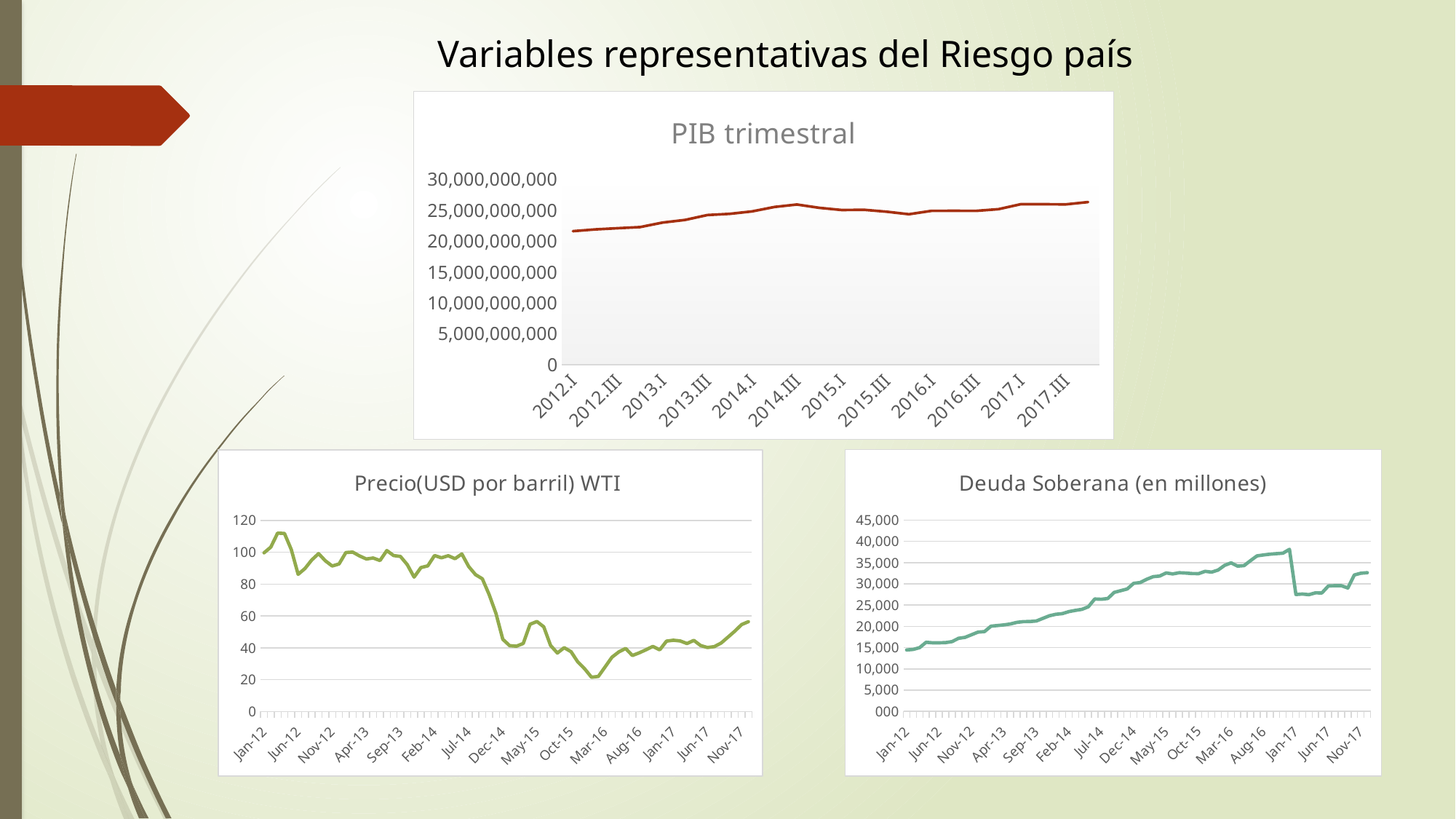
In the 'PIB trimestral' chart, is the value for 2017.III greater or less than 25,000,000,000? greater What kind of chart is the 'PIB trimestral' chart? line chart In the 'Deuda Soberana (en millones)' chart, is the value for Nov-17 greater or less than 30,000? greater In the 'Precio(USD por barril) WTI' chart, do the values overall rise or fall from Jan-12 to Nov-17? fall In the 'Precio(USD por barril) WTI' chart, is the value for Jan-12 greater or less than 80? greater What kind of chart is the 'Precio(USD por barril) WTI' chart? line chart In the 'PIB trimestral' chart, do the values overall rise or fall from 2012.I to 2017.III? rise In the 'Deuda Soberana (en millones)' chart, do the values overall rise or fall from Jan-12 to Nov-17? rise How many charts are shown on the slide? 3